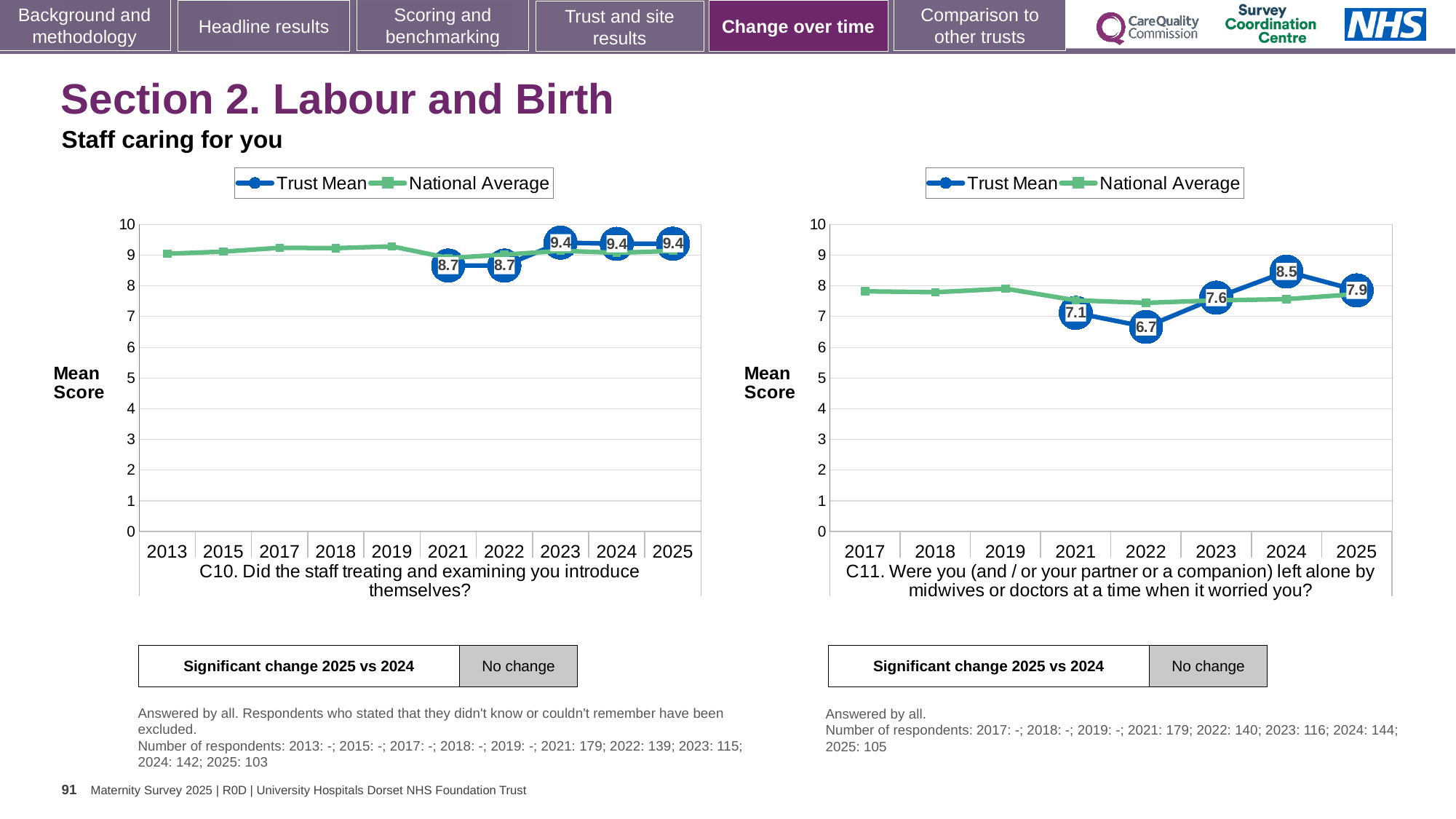
In the C10 chart (left), what is the Trust Mean for 2025? 9.4 In the C11 chart (right), which year has the lowest Trust Mean? 2022 In the C11 chart (right), which year has the highest Trust Mean? 2024 In the C10 chart (left), what is the difference between the Trust Mean in 2023 and in 2022? 0.7 What kind of chart is the C11 chart (right)? Line chart In the C11 chart (right), how many series does the legend list? 2 In the C11 chart (right), is the Trust Mean higher in 2023 or in 2021? 2023 In the C10 chart (left), how many years are shown on the x axis? 10 In the C10 chart (left), what is the Trust Mean for 2021? 8.7 In the C11 chart (right), what is the difference between the Trust Mean in 2024 and in 2025? 0.6 In the C10 chart (left), is the National Average for 2013 greater or less than 8? greater In the C11 chart (right), what is the Trust Mean for 2022? 6.7